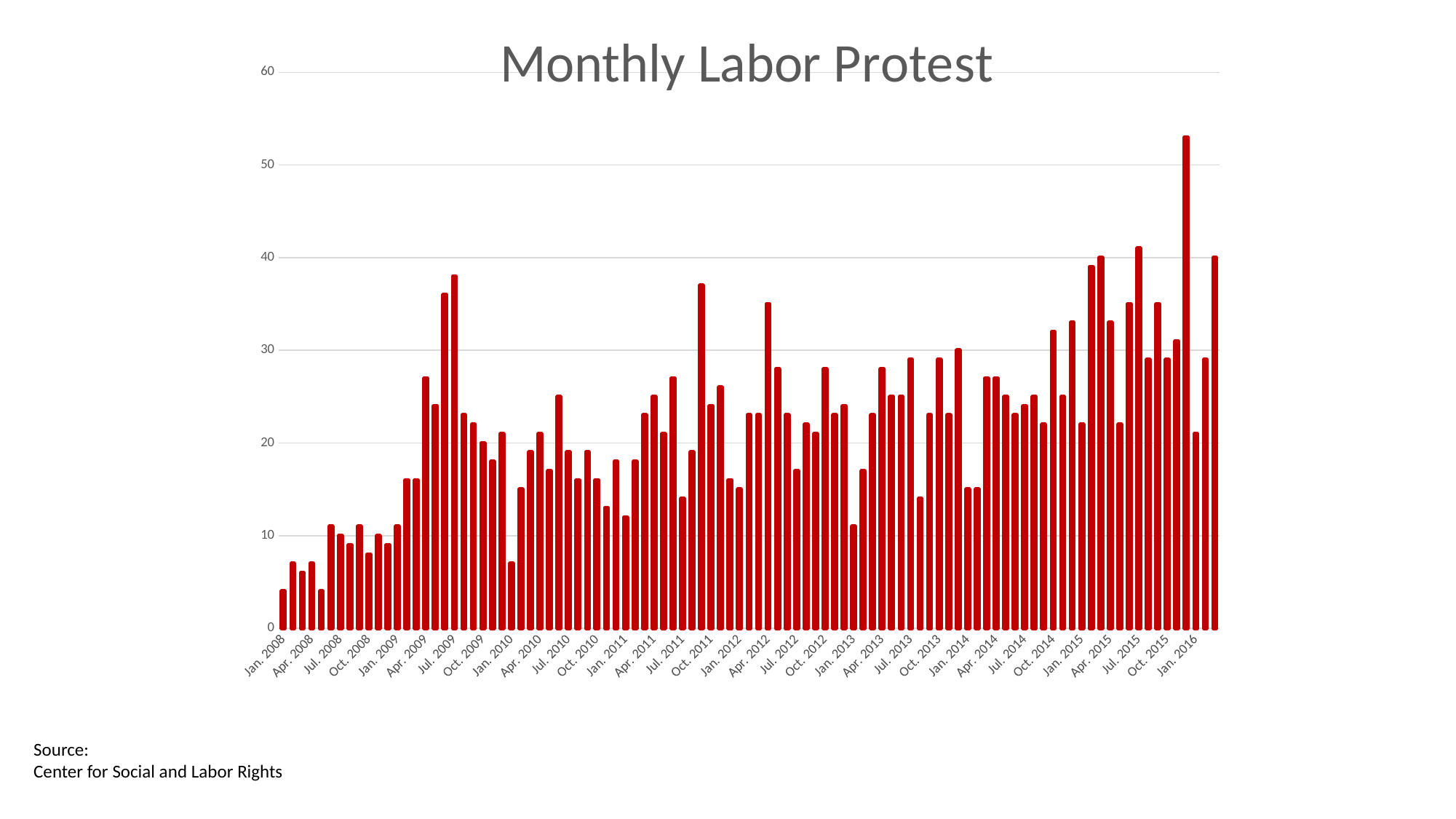
What source is cited for the chart data? Center for Social and Labor Rights Is the value for Jan. 2015 greater or less than 20? greater Do the monthly values generally rise or fall from 2008 to 2016? rise Which is larger, the value for Jan. 2008 or the value for Jan. 2015? Jan. 2015 What kind of chart is shown on the slide? bar chart What is the title of the chart? Monthly Labor Protest Is the value for Jan. 2011 greater or less than 20? less Is the value for Jan. 2009 greater or less than 20? less Which is larger, the value for Jan. 2008 or the value for Jan. 2009? Jan. 2009